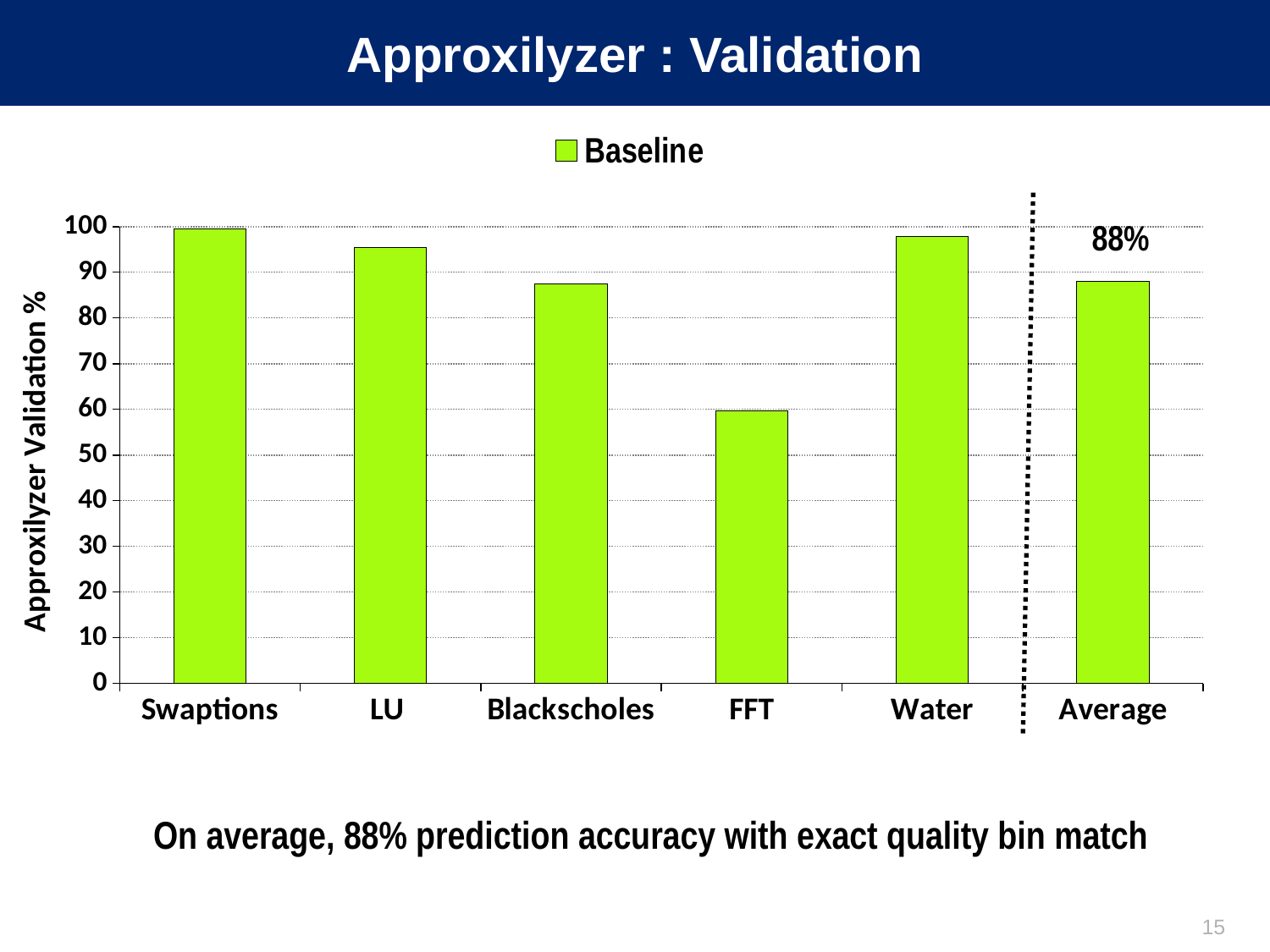
What kind of chart is shown on the slide? bar chart Is the value for Blackscholes greater or less than 90? less Which is larger, the value for LU or the value for Blackscholes? LU What is the name of the series in the legend? Baseline Is the value for LU greater or less than 90? greater Is the value for FFT greater or less than 50? greater Which is larger, the value for Water or the value for FFT? Water How many series does the legend list? 1 How many categories are shown on the x axis? 6 What is the value shown for Average? 88% Which category has the lowest Approxilyzer Validation %? FFT